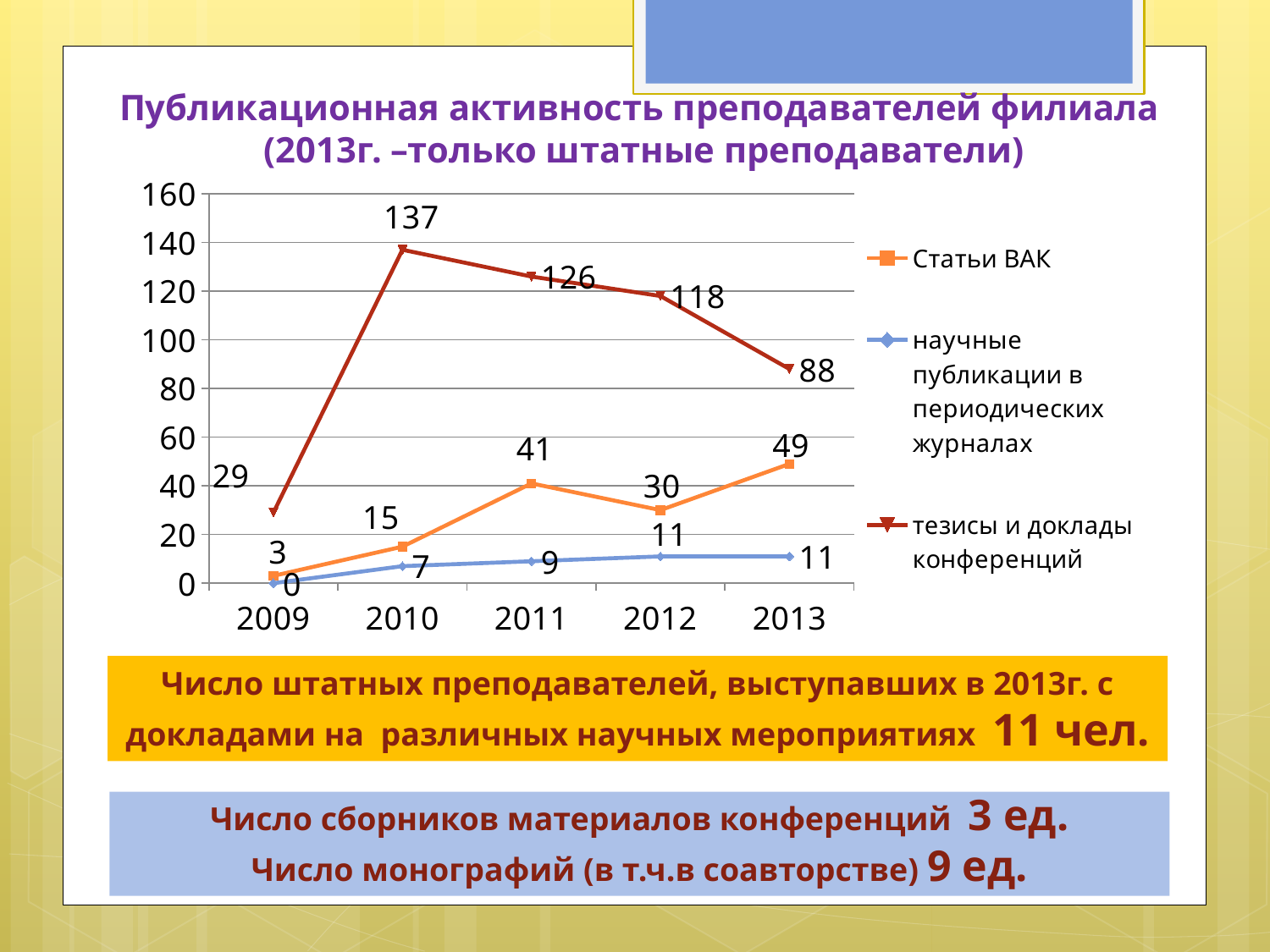
What is the difference between the тезисы и доклады конференций values in 2010 and 2013? 49 Does the value for тезисы и доклады конференций rise or fall from 2010 to 2013? fall Which is larger in 2012: Статьи ВАК or научные публикации в периодических журналах? Статьи ВАК In which year is the value for тезисы и доклады конференций highest? 2010 What type of chart is shown on the slide? line chart What is the value for тезисы и доклады конференций in 2010? 137 Which series is drawn in dark red? тезисы и доклады конференций How many years are shown on the x axis? 5 What is the value for Статьи ВАК in 2013? 49 In which year is the value for Статьи ВАК lowest? 2009 What is the value for научные публикации в периодических журналах in 2009? 0 How many series does the legend list? 3